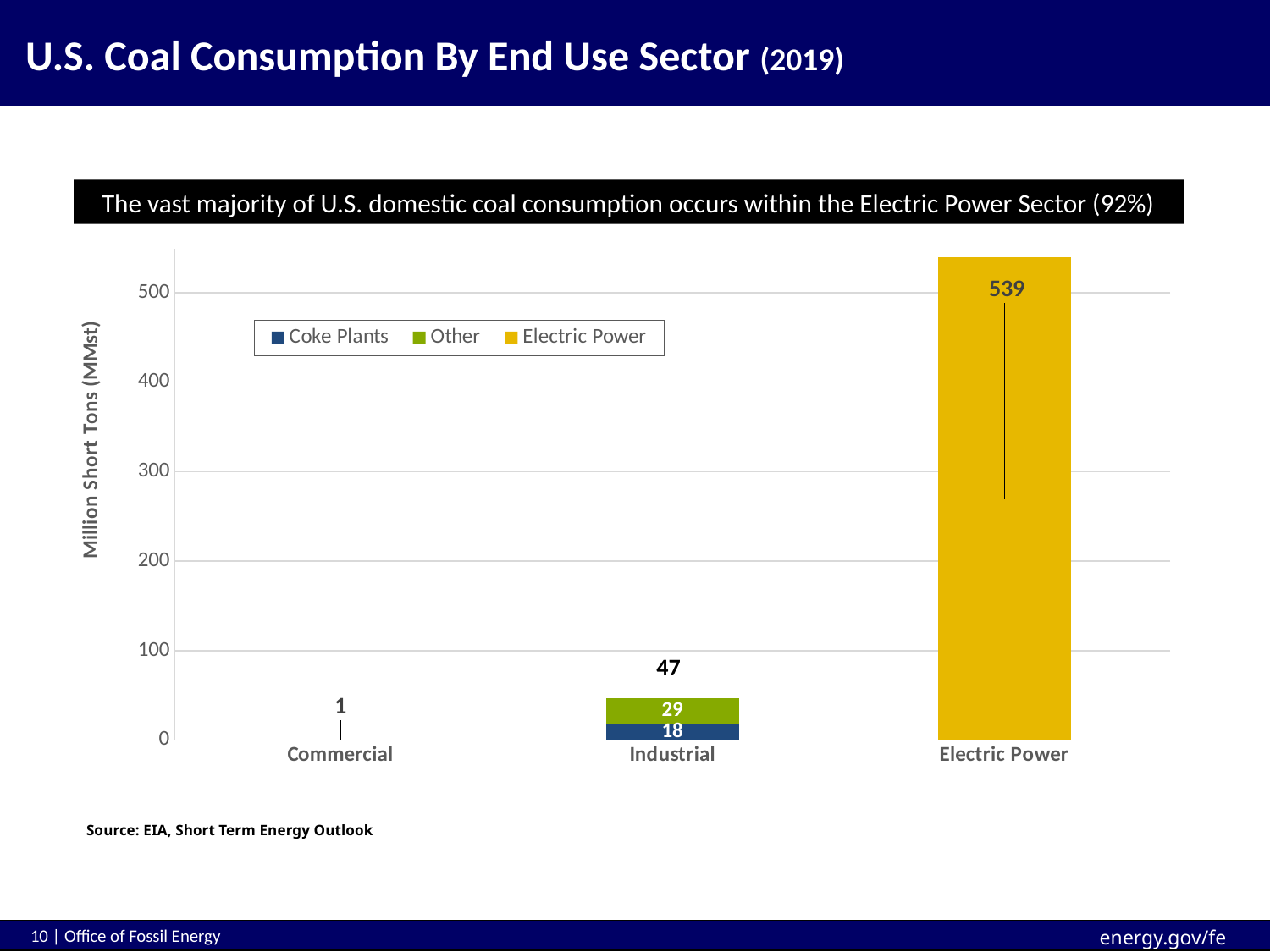
What is the difference between the Electric Power total and the Industrial total? 492 What is the Other value within the Industrial sector? 29 What kind of chart is shown on the slide? Bar chart What is the total coal consumption for the Electric Power sector? 539 What is the total coal consumption for the Industrial sector? 47 Which sector has the lowest coal consumption? Commercial Which sector has the highest coal consumption? Electric Power How many sectors are shown on the x axis? 3 What is the coal consumption for the Commercial sector? 1 What is the Coke Plants value within the Industrial sector? 18 How many series does the legend list? 3 Within the Industrial sector, which is larger: Coke Plants or Other? Other